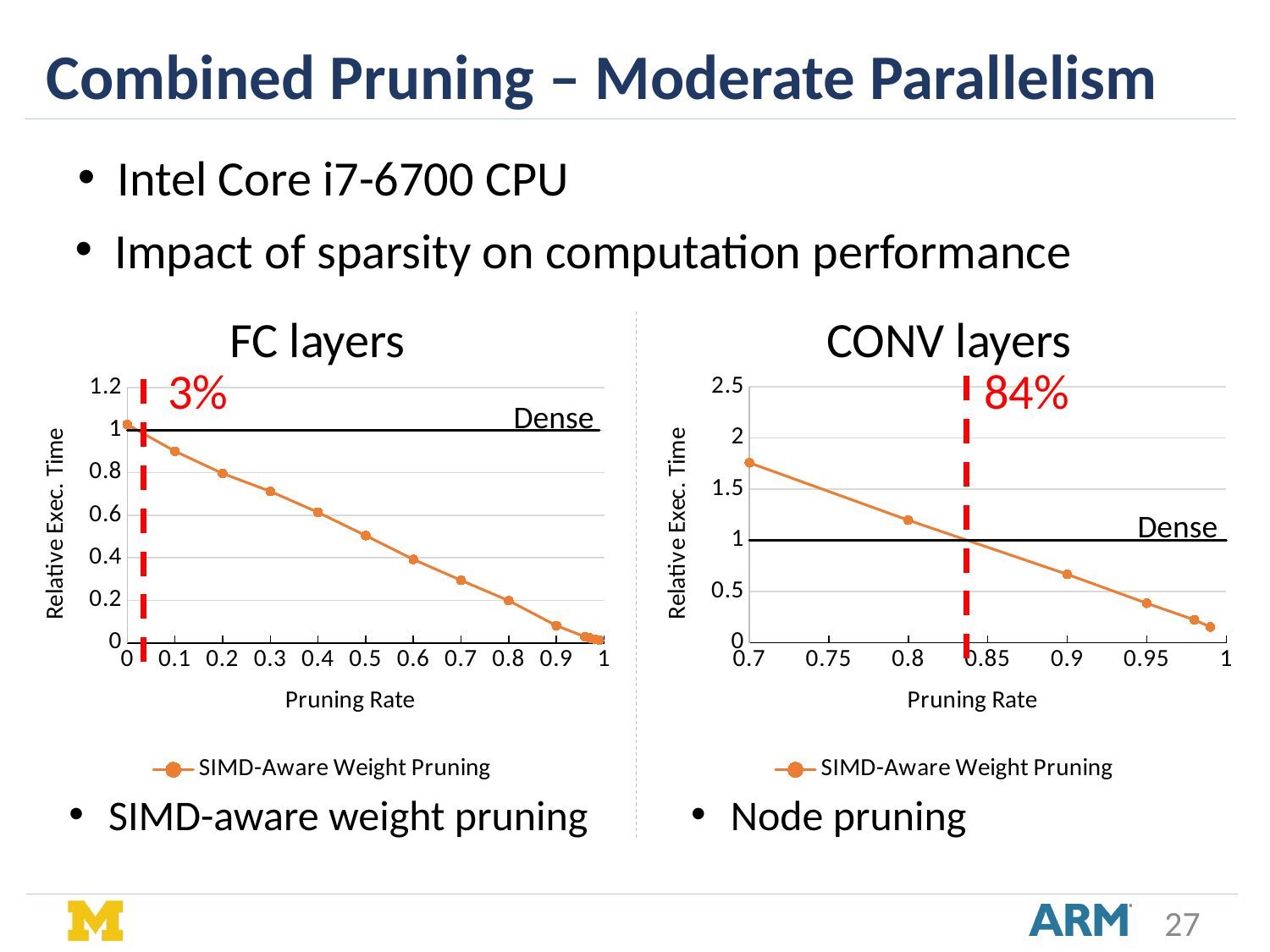
In the CONV layers chart, how many series does the legend list? 1 In the FC layers chart, what kind of chart is shown? line chart In the FC layers chart, what is the name of the series shown in the legend? SIMD-Aware Weight Pruning In the FC layers chart, is the relative execution time at pruning rate 0.1 greater or less than 0.8? greater In the CONV layers chart, is the relative execution time at pruning rate 0.9 greater or less than 1? less In the CONV layers chart, at which pruning rate is the relative execution time highest? 0.7 In the FC layers chart, is the relative execution time at pruning rate 0.9 greater or less than 0.2? less In the FC layers chart, which has the larger relative execution time: pruning rate 0.2 or pruning rate 0.6? 0.2 In the CONV layers chart, what percentage is written next to the red dashed vertical line? 84% In the FC layers chart, does the relative execution time rise or fall as the pruning rate increases? fall In the CONV layers chart, does the relative execution time rise or fall as the pruning rate increases? fall